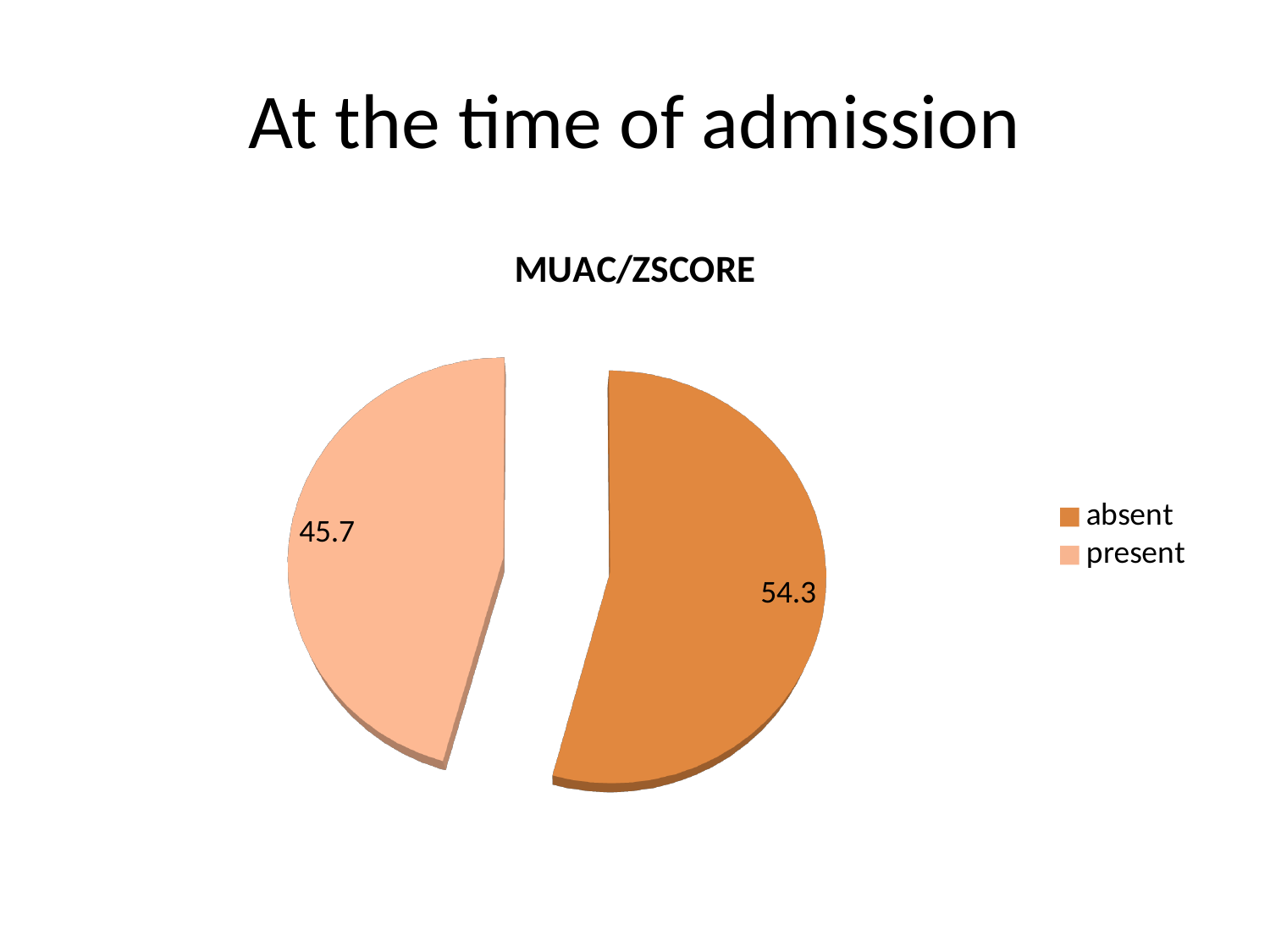
Which category has the smallest slice in the MUAC/ZSCORE pie chart? present How many entries does the legend of the MUAC/ZSCORE chart list? 2 Which legend entry is shown in the darker orange colour in the MUAC/ZSCORE pie chart? absent Which category has the largest slice in the MUAC/ZSCORE pie chart? absent What is the title of the chart on the slide? MUAC/ZSCORE Which is larger in the MUAC/ZSCORE pie chart, 'absent' or 'present'? absent What kind of chart is shown on the slide? pie chart How many slices does the MUAC/ZSCORE pie chart have? 2 What is the value for the 'present' slice in the MUAC/ZSCORE pie chart? 45.7 What is the difference between the 'absent' and 'present' values in the MUAC/ZSCORE pie chart? 8.6 What is the total of the two values shown in the MUAC/ZSCORE pie chart? 100 What is the value for the 'absent' slice in the MUAC/ZSCORE pie chart? 54.3